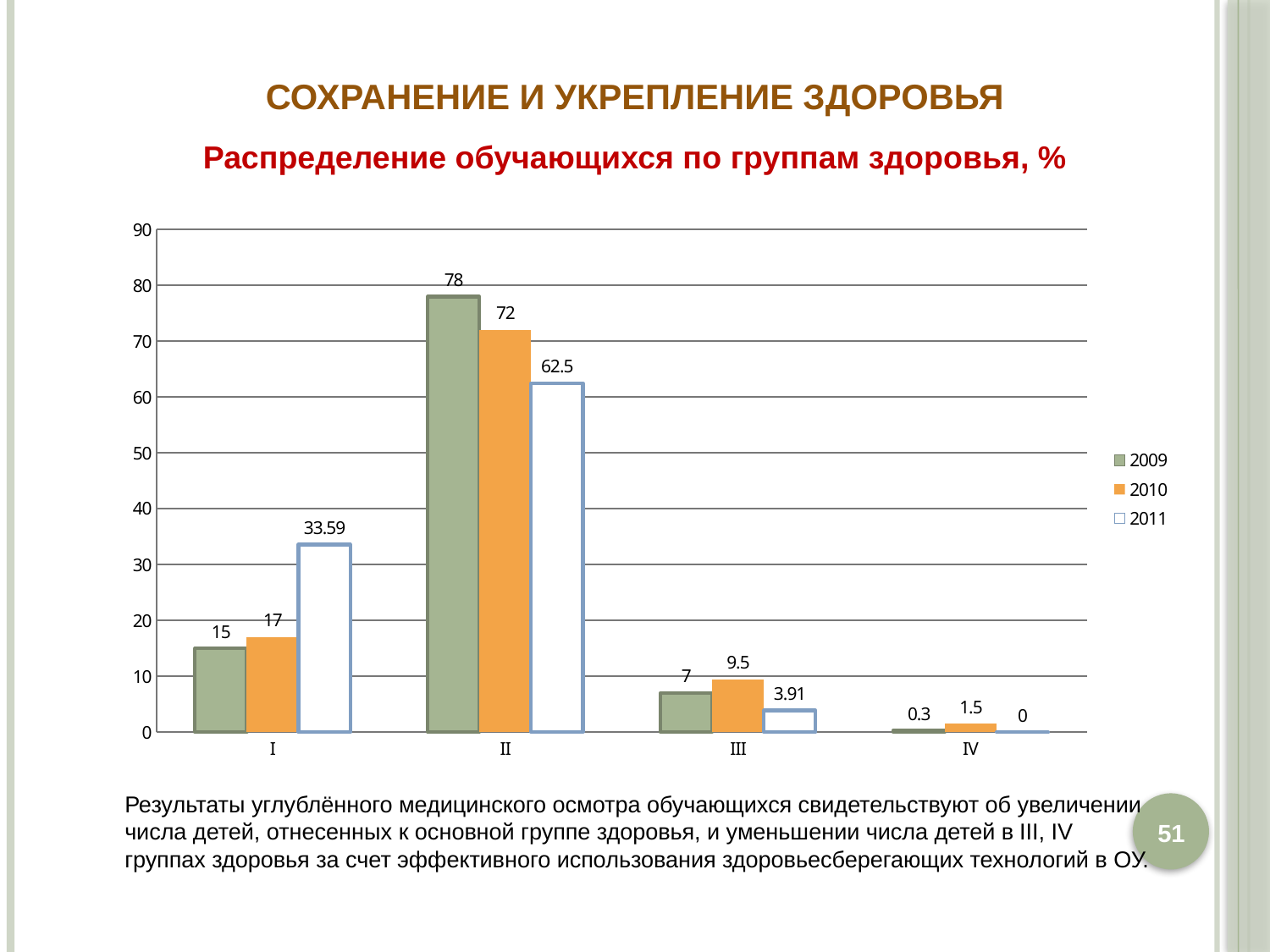
What is the value for group I in 2011? 33.59 How many series does the legend list? 3 Which is larger for group III: the 2010 value or the 2011 value? 2010 How many health groups are shown on the x axis? 4 Which health group has the lowest value in 2009? IV What kind of chart is shown on the slide? bar chart What is the value for group II in 2009? 78 What is the value for group IV in 2011? 0 What is the difference between the 2009 and 2011 values for group II? 15.5 Which health group has the highest value in 2010? II Do the values for group II rise or fall from 2009 to 2011? fall What is the value for group III in 2010? 9.5